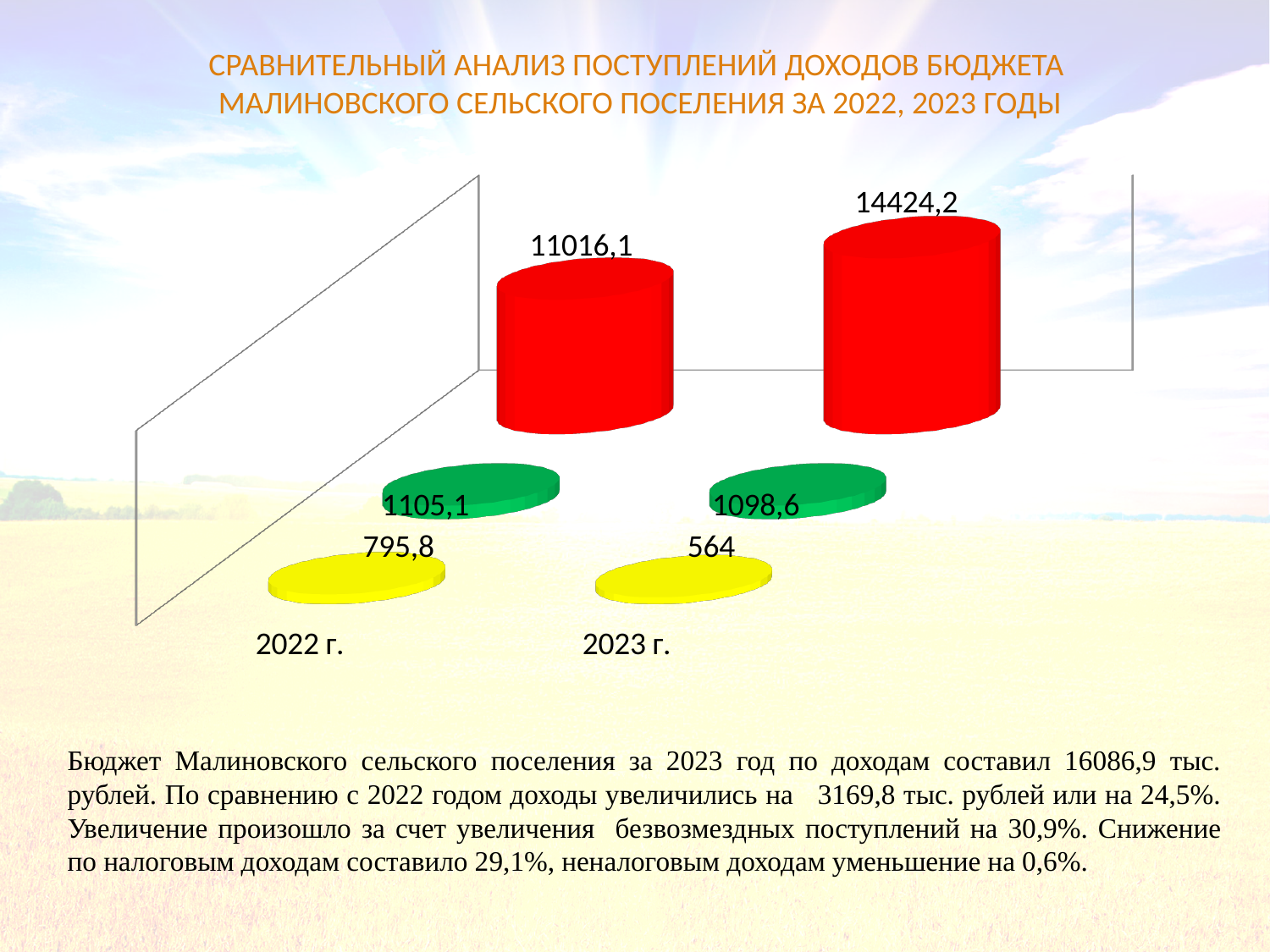
What is the value of the green cylinder for 2023 г.? 1098,6 What is the value of the yellow cylinder for 2022 г.? 795,8 How many years (categories) are shown on the x axis of the chart? 2 What is the value of the yellow cylinder for 2023 г.? 564 What is the value of the red cylinder for 2023 г.? 14424,2 What is the value of the green cylinder for 2022 г.? 1105,1 Which year has the higher value for the red series? 2023 г. Which year has the lower value for the yellow series? 2023 г. What type of chart is shown on the slide? Bar chart What is the difference between the yellow values for 2022 г. and 2023 г.? 231,8 What is the value of the red cylinder for 2022 г.? 11016,1 What is the difference between the red values for 2023 г. and 2022 г.? 3408,1